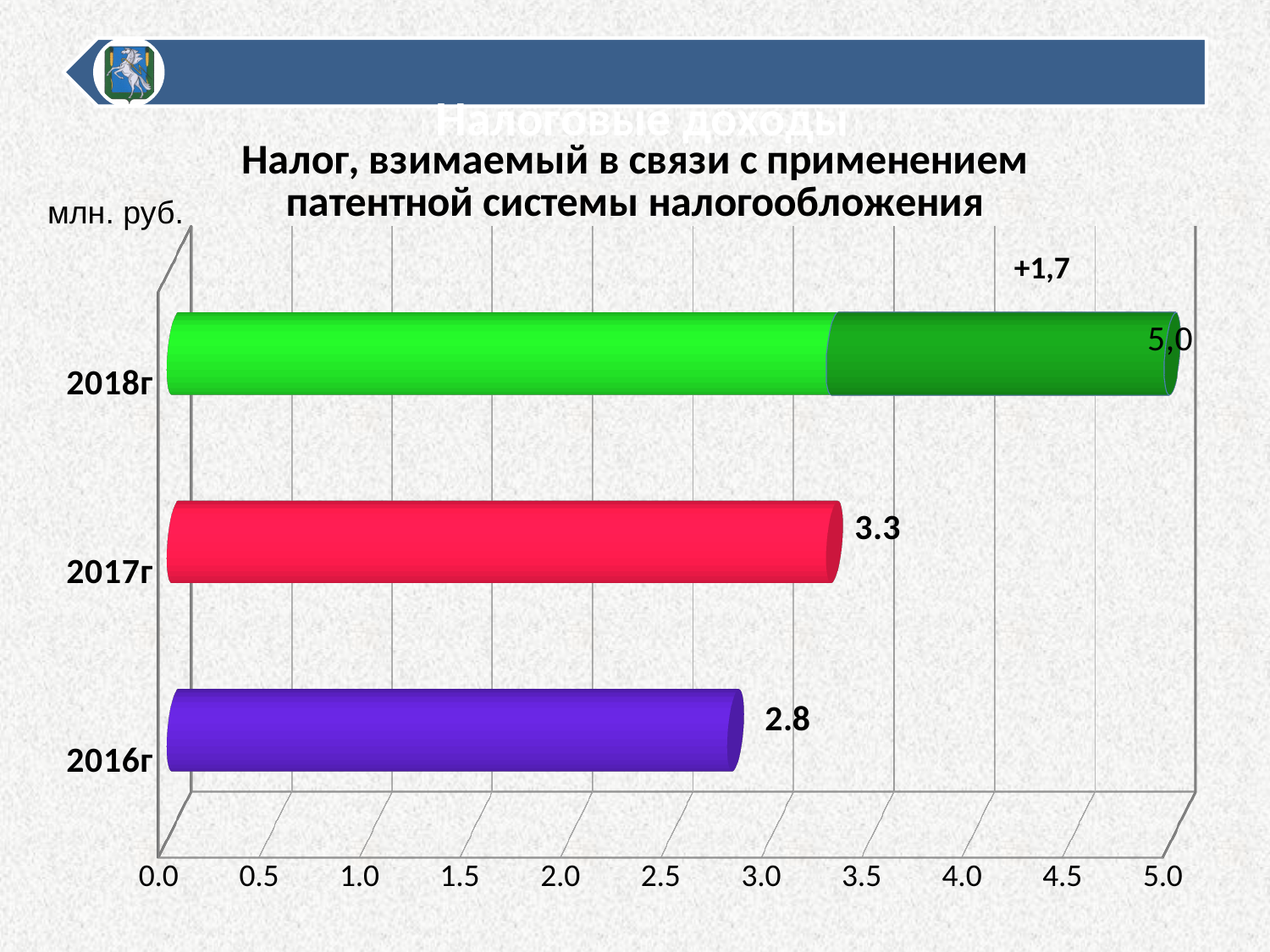
Which is larger, the value for 2017г or the value for 2016г? 2017г What is the value for 2018г? 5,0 What is the increase shown for 2018г compared with 2017г? +1,7 Is the value for 2017г greater or less than 3.0? greater Which year has the lowest value? 2016г What is the value for 2017г? 3.3 What kind of chart is shown on the slide? bar chart Which year has the highest value? 2018г How many years are shown in the chart? 3 What is the difference between the values for 2017г and 2016г? 0.5 What unit of measurement is indicated for the chart? млн. руб. What is the value for 2016г? 2.8